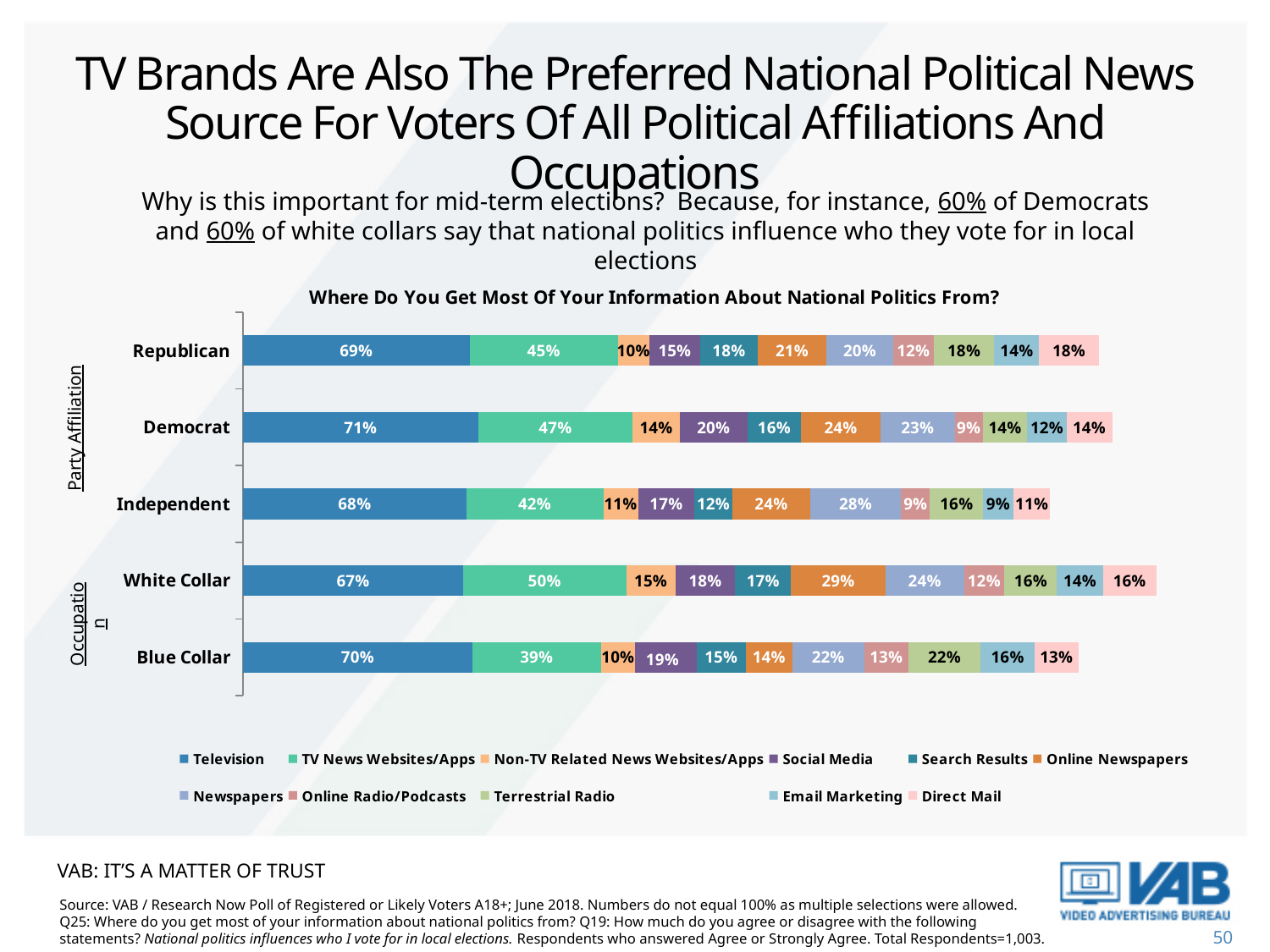
Which group has the lowest TV News Websites/Apps value? Blue Collar What is the title of the chart? Where Do You Get Most Of Your Information About National Politics From? What percentage of Democrats say they get most of their national politics information from Television? 71% What is the difference in percentage points between the Television values for Democrat and White Collar? 4 percentage points What is the Newspapers value for Independent voters? 28% What kind of chart is shown on the slide? Stacked bar chart Which has a larger Online Newspapers value, White Collar or Blue Collar? White Collar How many news sources does the legend list? 11 How many voter groups are shown on the chart? 5 Which group has the highest Television value? Democrat What is the Social Media value for Democrats? 20% What is the TV News Websites/Apps value for White Collar voters? 50%